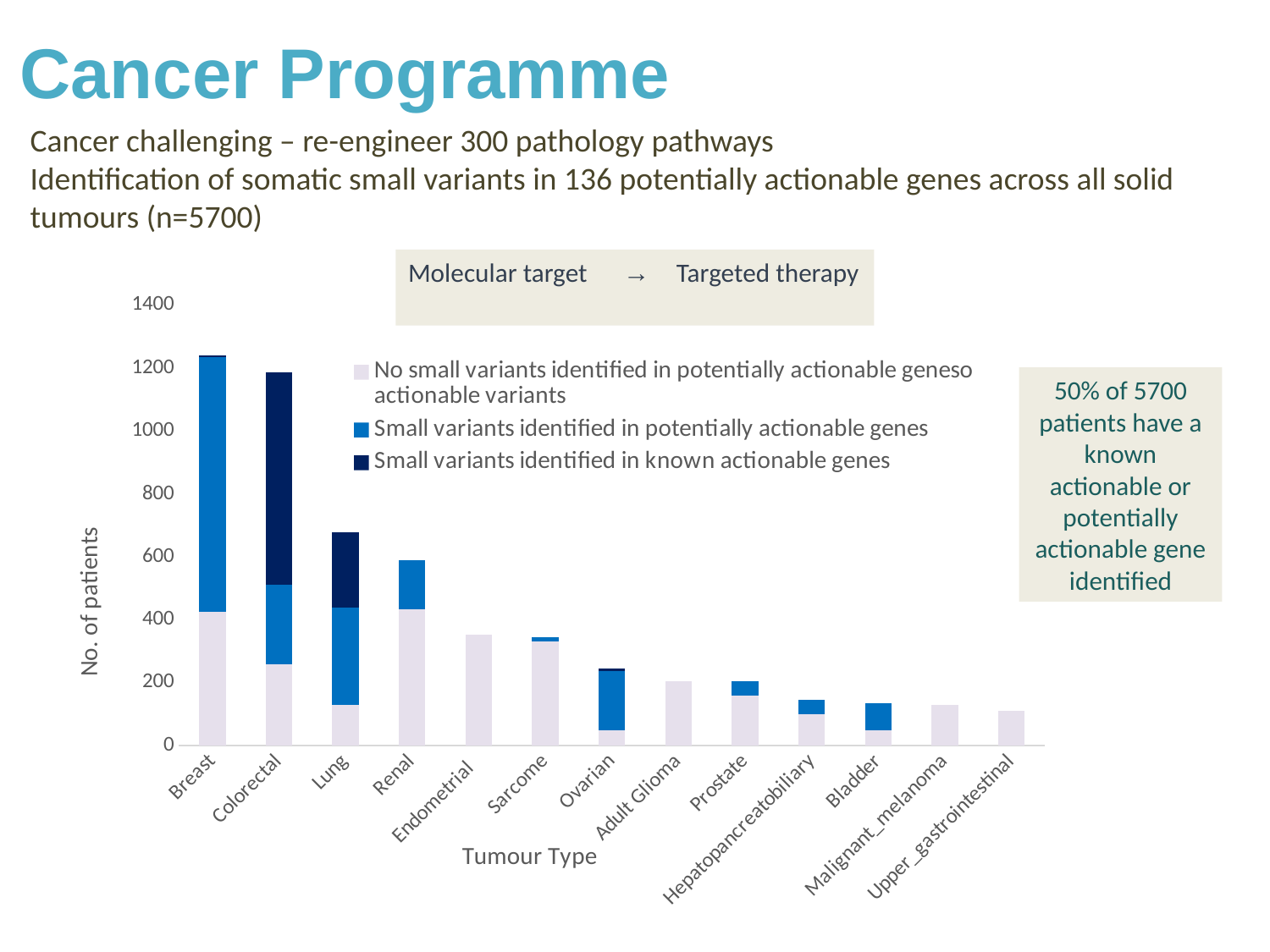
How many series does the chart's legend list? 3 Which has the taller bar, Lung or Renal? Lung Which tumour type has the tallest bar in the chart? Breast How many tumour types are shown on the x axis of the chart? 13 Is the total bar height for Endometrial greater or less than 400? less Is the total bar height for Breast greater or less than 1200? greater Which tumour type has the shortest bar in the chart? Upper_gastrointestinal Do the bar heights generally rise or fall moving from left to right along the x axis? fall What is the label on the vertical axis of the chart? No. of patients What kind of chart is shown on the slide? Stacked bar chart Is the total bar height for Lung greater or less than 600? greater